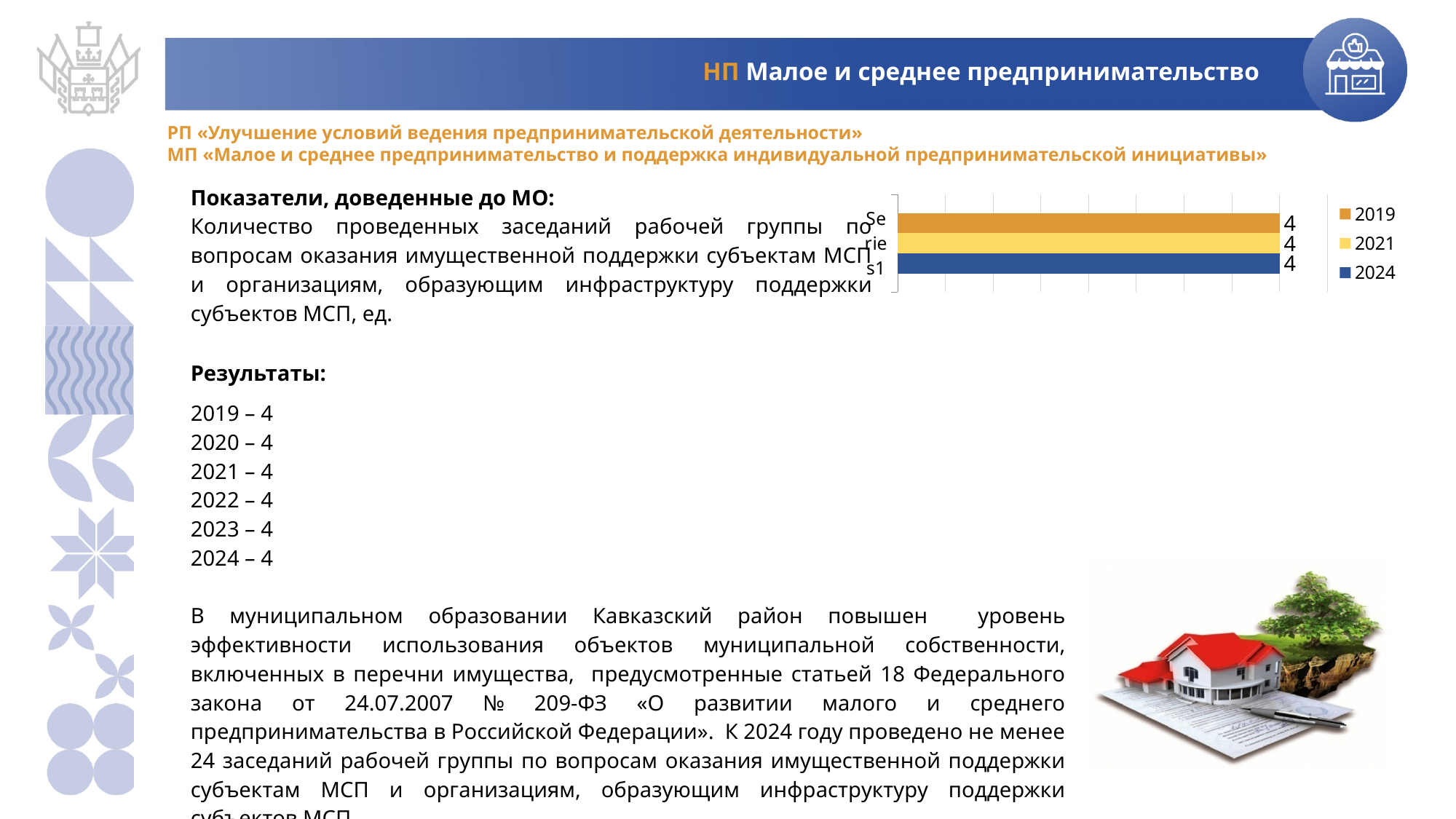
What is the difference between the 2021 value and the 2024 value in the chart? 0 What is the value of the 2019 bar in the chart? 4 What is the value of the 2024 bar in the chart? 4 How many series does the chart legend list? 3 What is the value of the 2021 bar in the chart? 4 What kind of chart is shown on the slide? bar chart Which years are listed in the chart legend? 2019, 2021, 2024 What colour is the 2024 series in the chart? blue How many bars are plotted in the chart? 3 What is the difference between the 2024 value and the 2019 value in the chart? 0